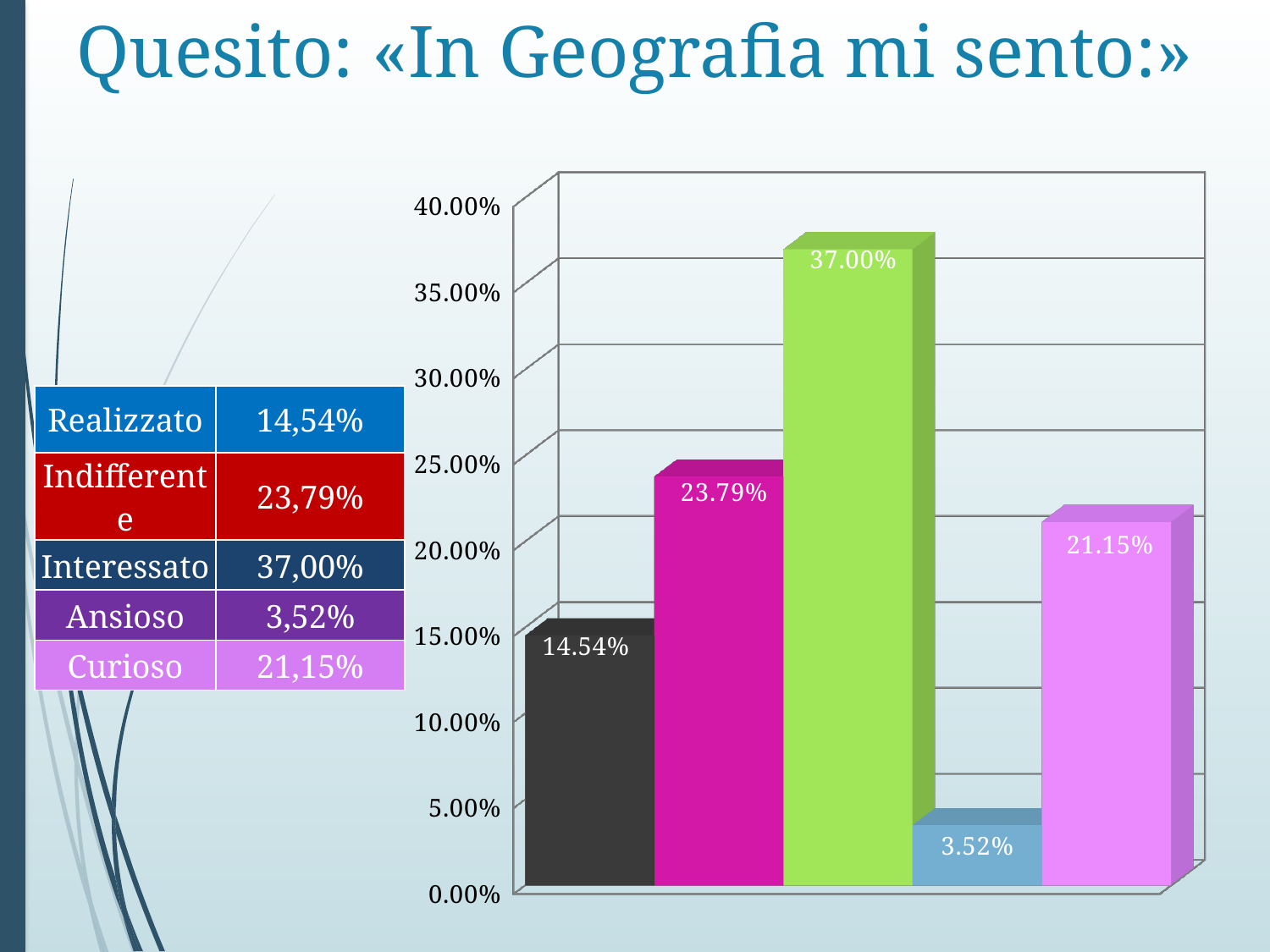
Is the value of the green bar greater or less than 35.00%? greater What is the data label on the second bar (magenta) of the chart? 23.79% What is the data label on the last (rightmost) bar of the chart? 21.15% What is the difference between the tallest bar (37.00%) and the shortest bar (3.52%)? 33.48% Which is larger: the second bar (23.79%) or the fifth bar (21.15%)? the second bar (23.79%) What is the data label on the first (leftmost) bar of the chart? 14.54% According to the table, which category corresponds to the 37,00% value? Interessato What kind of chart is shown on the slide? bar chart What is the value shown on the shortest bar in the chart? 3.52% What is the value shown on the tallest bar in the chart? 37.00% How many bars are plotted in the chart? 5 What is the highest value shown on the vertical axis of the chart? 40.00%